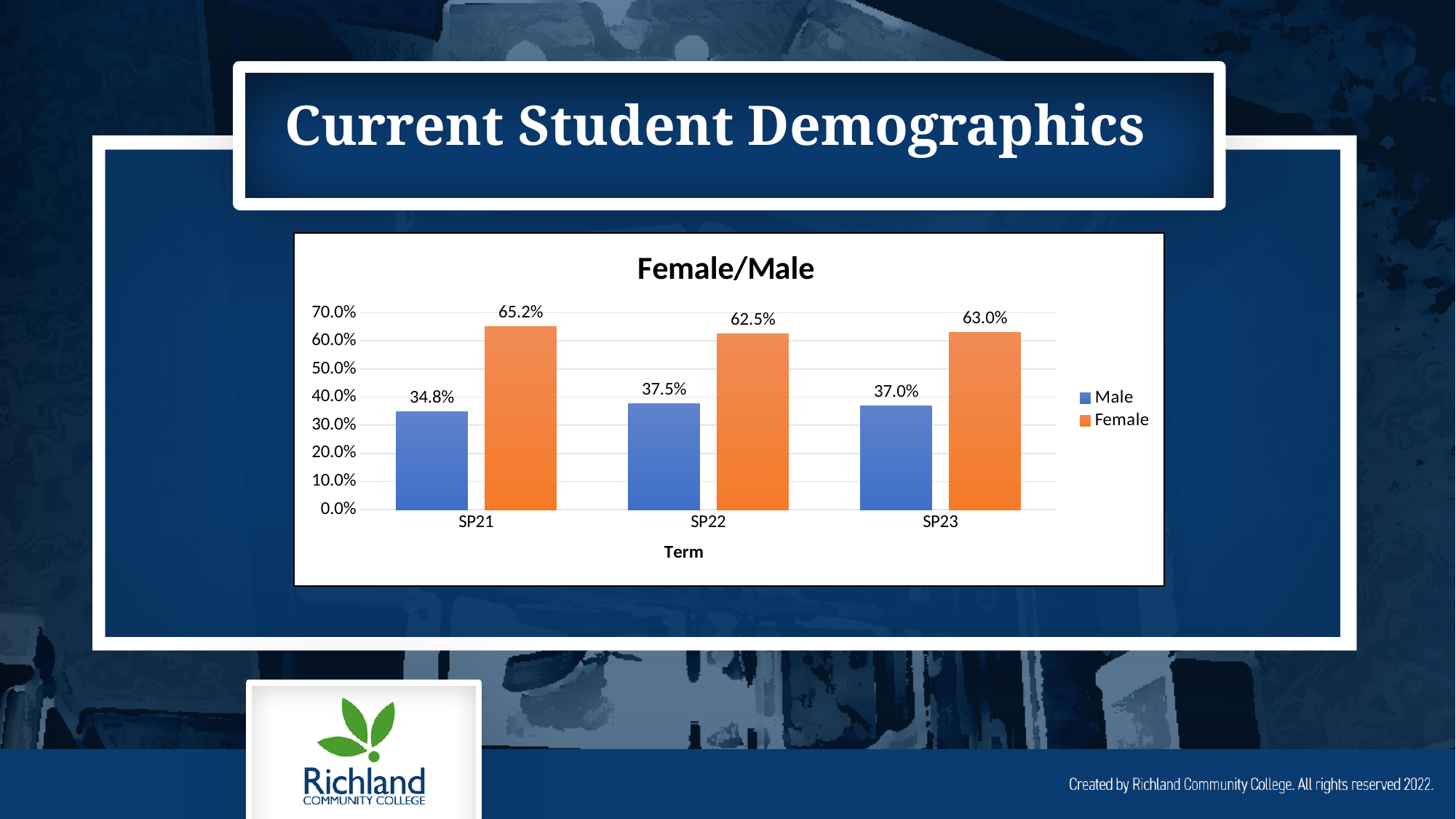
What is the difference between the Female and Male values for SP22? 25.0% Which is larger, the Male value for SP22 or the Male value for SP23? SP22 How many terms are shown on the x axis? 3 What is the Male value for SP23? 37.0% What is the Male value for SP22? 37.5% Which term has the lowest Male value? SP21 What is the Female value for SP23? 63.0% Which term has the highest Female value? SP21 What is the Female value for SP21? 65.2% What kind of chart is shown? Bar chart How many series does the legend list? 2 What is the title of the chart? Female/Male